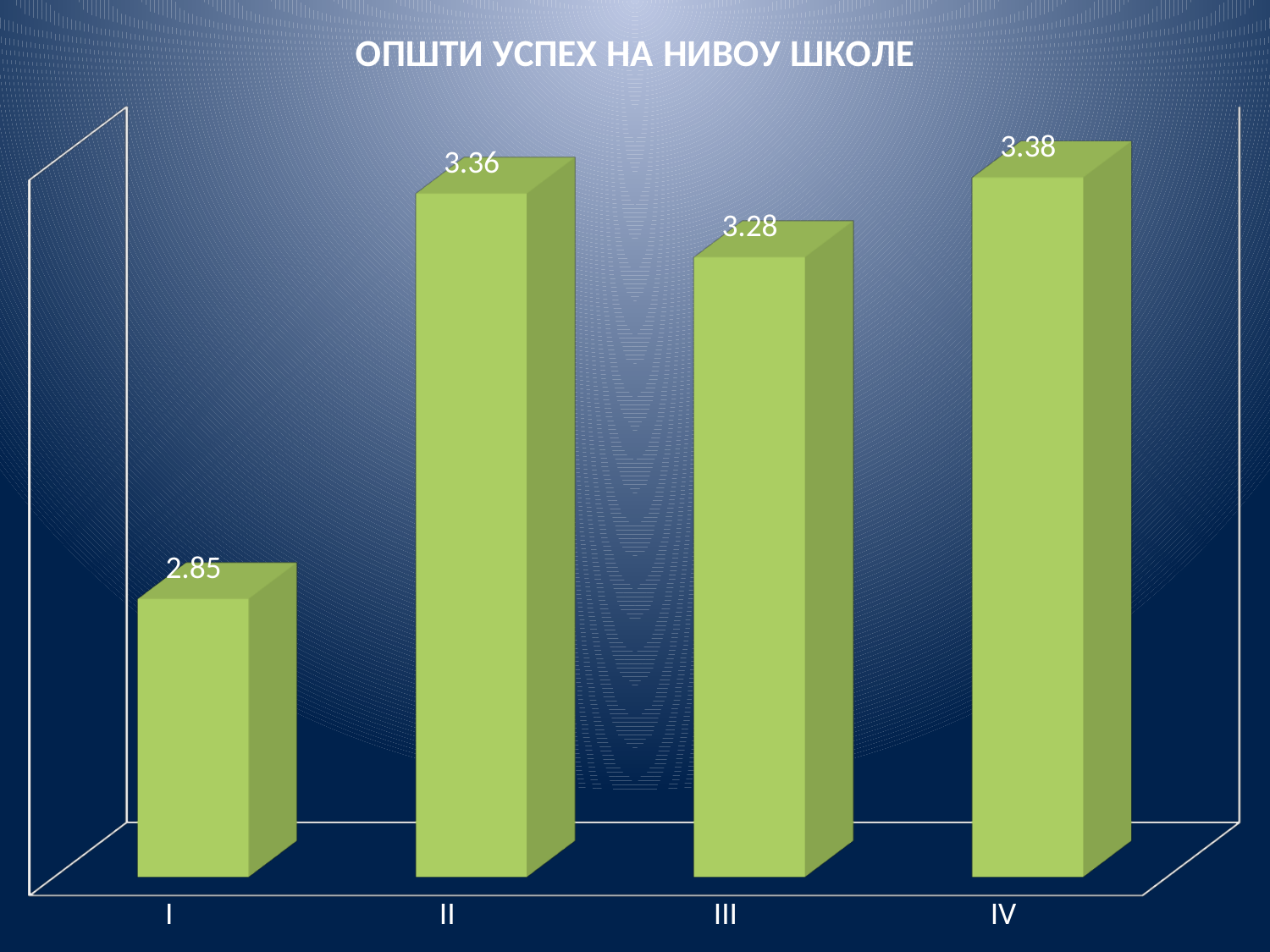
Which category has the highest value? IV What is the difference between the values for IV and III? 0.10 What kind of chart is shown on the slide? bar chart What is the value for category I? 2.85 Which category has the lowest value? I What is the title of the chart? ОПШТИ УСПЕХ НА НИВОУ ШКОЛЕ What is the value for category II? 3.36 What is the value for category III? 3.28 What is the value for category IV? 3.38 How many categories are shown on the x axis? 4 Which is larger, the value for II or the value for III? II What is the difference between the values for II and I? 0.51